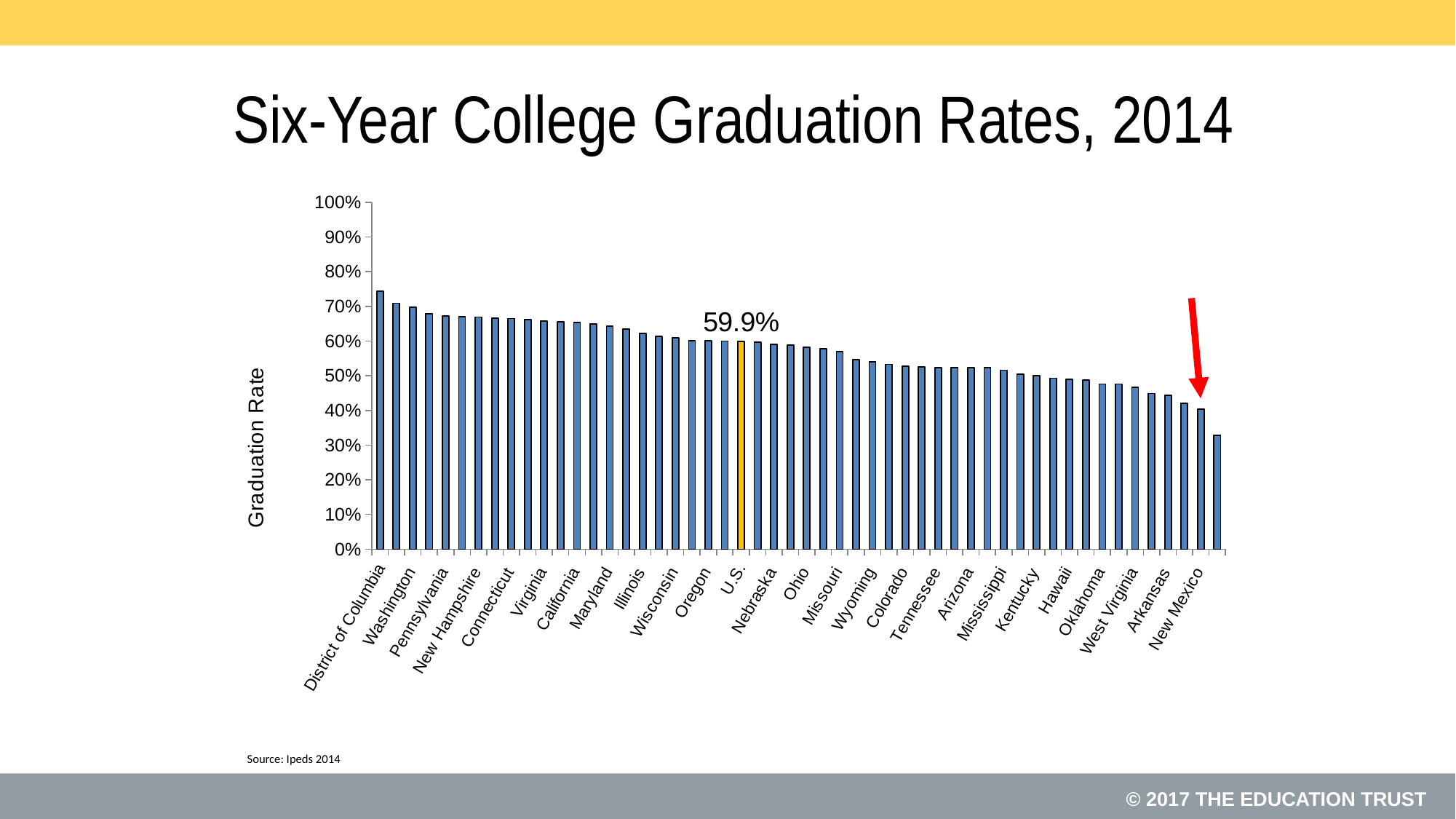
Is the value for Ohio greater or less than 50%? greater What is the six-year college graduation rate shown for the U.S.? 59.9% Is the value for Maryland greater or less than 60%? greater Which has a higher graduation rate, Washington or Arkansas? Washington Is the value for District of Columbia greater or less than 70%? greater Which bar is highlighted in a different colour (orange) from the others? U.S. Which category has the highest graduation rate on the chart? District of Columbia Do the graduation rates rise or fall moving from left to right along the x axis? Fall What is the title of the chart? Six-Year College Graduation Rates, 2014 What kind of chart is shown on the slide? Bar chart